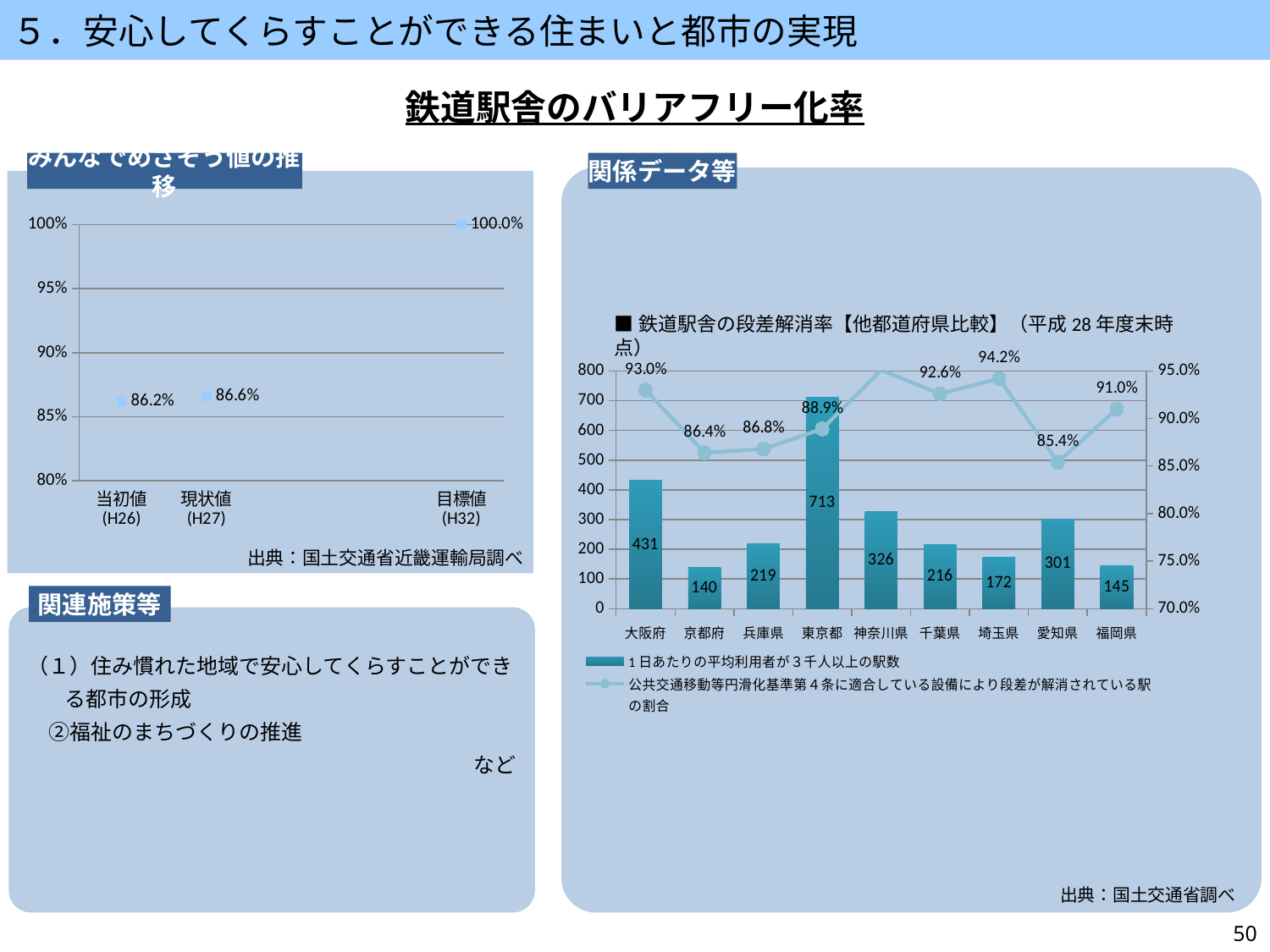
In the right chart (鉄道駅舎の段差解消率【他都道府県比較】), what is the value of the bar for 東京都? 713 In the right chart (鉄道駅舎の段差解消率【他都道府県比較】), which prefecture has the lowest bar? 京都府 In the right chart (鉄道駅舎の段差解消率【他都道府県比較】), which has a larger bar value, 兵庫県 or 千葉県? 兵庫県 In the left chart (みんなでめざそう値の推移), what is the value for 目標値 (H32)? 100.0% In the right chart (鉄道駅舎の段差解消率【他都道府県比較】), what is the line value (percentage) for 埼玉県? 94.2% In the left chart (みんなでめざそう値の推移), what is the value for 現状値 (H27)? 86.6% In the right chart (鉄道駅舎の段差解消率【他都道府県比較】), how many series does the legend list? 2 In the right chart (鉄道駅舎の段差解消率【他都道府県比較】), how many prefectures are shown on the x axis? 9 In the right chart (鉄道駅舎の段差解消率【他都道府県比較】), what is the value of the bar for 京都府? 140 In the right chart (鉄道駅舎の段差解消率【他都道府県比較】), what is the difference between the bar values for 大阪府 and 愛知県? 130 In the left chart (みんなでめざそう値の推移), do the values rise or fall from 当初値 (H26) to 目標値 (H32)? rise In the right chart (鉄道駅舎の段差解消率【他都道府県比較】), which prefecture has the highest bar? 東京都